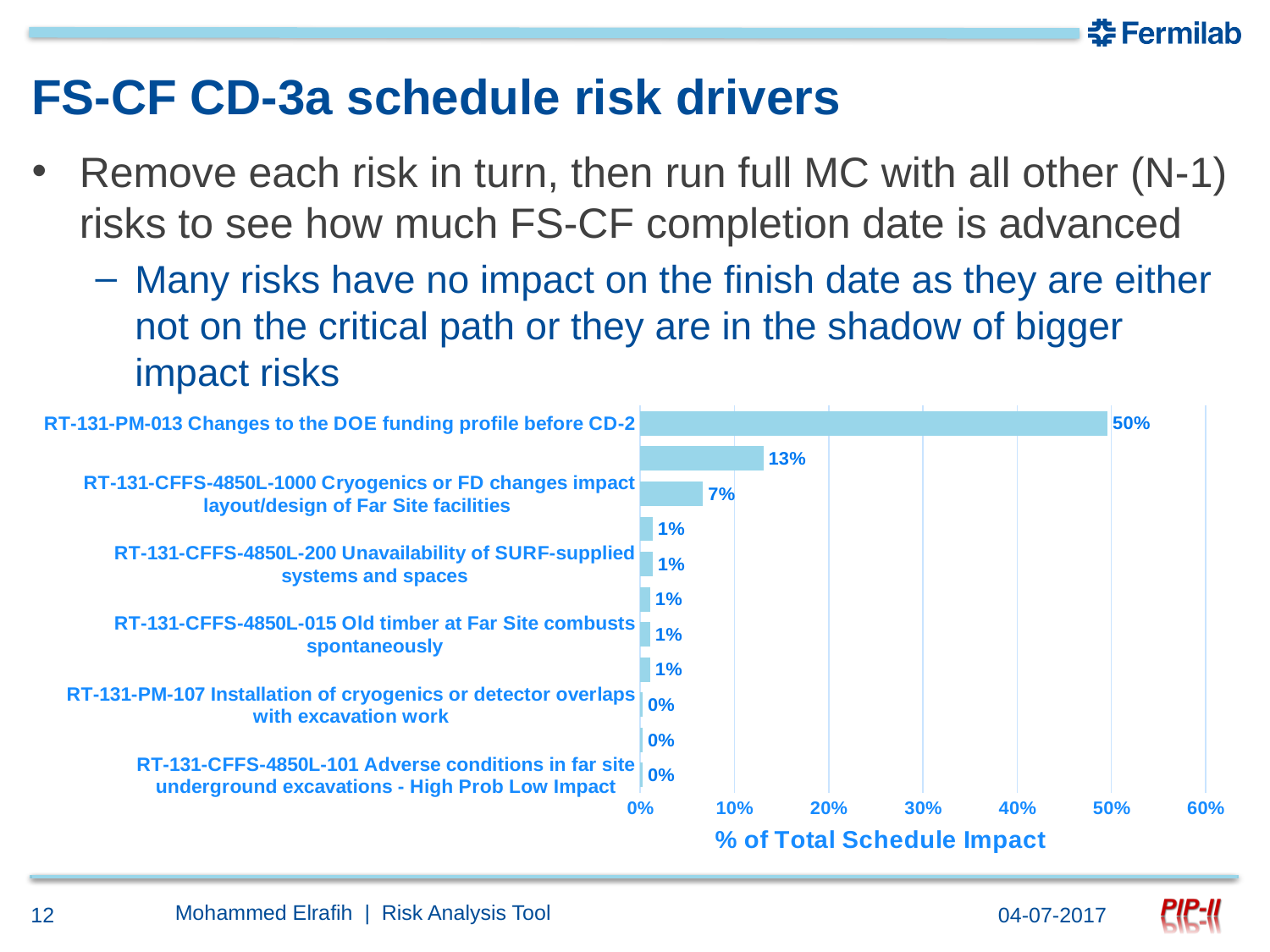
Is the value for RT-131-PM-013 Changes to the DOE funding profile before CD-2 greater or less than 40%? greater What is the value for RT-131-PM-107 Installation of cryogenics or detector overlaps with excavation work? 0% What is the title of the horizontal axis of the chart? % of Total Schedule Impact What is the value for RT-131-PM-013 Changes to the DOE funding profile before CD-2? 50% What is the value for RT-131-CFFS-4850L-200 Unavailability of SURF-supplied systems and spaces? 1% What kind of chart is shown on the slide? bar chart What is the highest value shown on the horizontal axis of the chart? 60% How many bars are plotted in the chart? 11 What is the value for RT-131-CFFS-4850L-1000 Cryogenics or FD changes impact layout/design of Far Site facilities? 7% Which is larger: the value for RT-131-CFFS-4850L-1000 Cryogenics or FD changes impact layout/design of Far Site facilities or the value for RT-131-CFFS-4850L-200 Unavailability of SURF-supplied systems and spaces? RT-131-CFFS-4850L-1000 Cryogenics or FD changes impact layout/design of Far Site facilities Which risk has the highest % of Total Schedule Impact? RT-131-PM-013 Changes to the DOE funding profile before CD-2 What is the difference between the value for RT-131-PM-013 Changes to the DOE funding profile before CD-2 and the value for RT-131-CFFS-4850L-1000 Cryogenics or FD changes impact layout/design of Far Site facilities? 43%